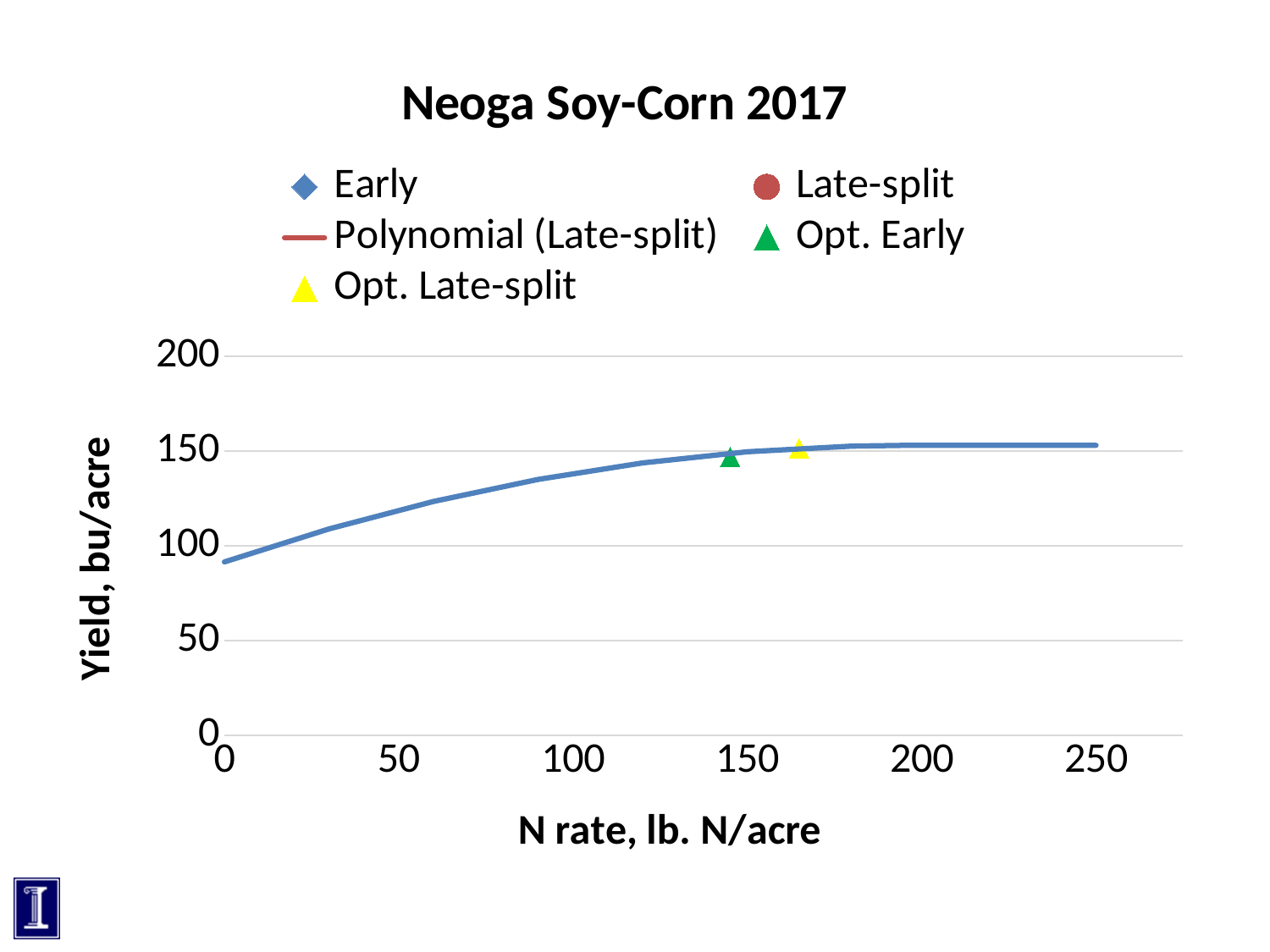
What kind of chart is shown on the slide? Scatter chart with a fitted curve How many series does the legend list? 5 What is the highest N rate tick shown on the x axis? 250 Which marker sits at a higher N rate: Opt. Early or Opt. Late-split? Opt. Late-split Which is larger: the yield on the curve at an N rate of 0 or at an N rate of 250? At 250 Does the yield curve rise or fall as N rate increases from 0 to 250? Rises What is the label of the y axis? Yield, bu/acre Is the yield on the curve at an N rate of 100 greater or less than 150? less What is the title of the chart? Neoga Soy-Corn 2017 Is the yield on the curve at an N rate of 50 greater or less than 100? greater Is the yield on the curve at an N rate of 250 greater or less than 100? greater